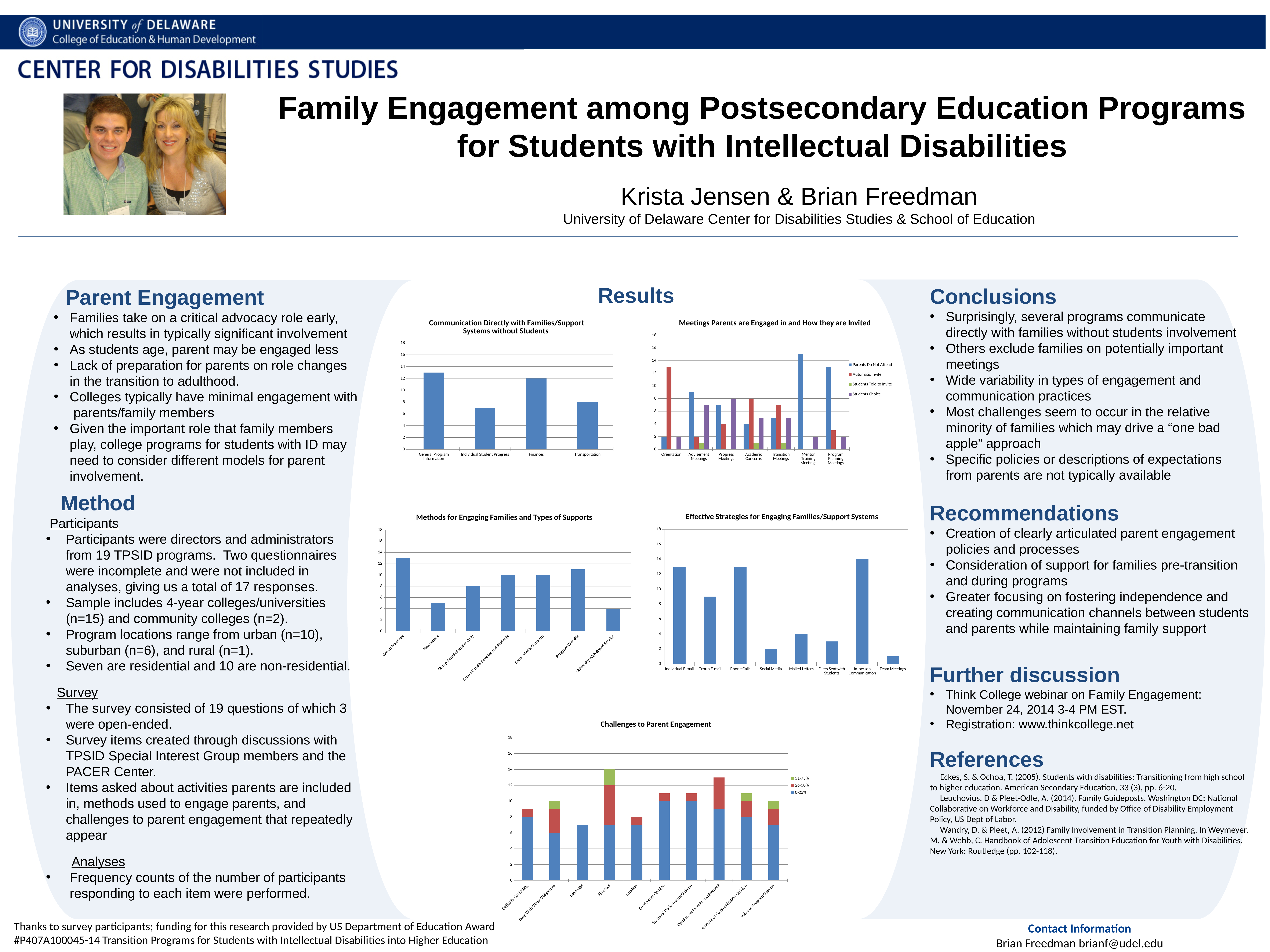
In the "Meetings Parents are Engaged in and How they are Invited" chart, which category has the highest "Parents Do Not Attend" value? Mentor Training Meetings How many series does the legend of the "Challenges to Parent Engagement" chart list? 3 How many categories does the "Communication Directly with Families/Support Systems without Students" chart show? 4 What kind of chart is the "Communication Directly with Families/Support Systems without Students" chart? bar chart In the "Communication Directly with Families/Support Systems without Students" chart, is the value for Individual Student Progress greater or less than 10? less In the "Effective Strategies for Engaging Families/Support Systems" chart, which category has the lowest value? Team Meetings How many categories does the "Effective Strategies for Engaging Families/Support Systems" chart show? 8 In the "Communication Directly with Families/Support Systems without Students" chart, which category has the highest value? General Program Information In the "Methods for Engaging Families and Types of Supports" chart, which is larger, Group Meetings or Newsletters? Group Meetings In the "Effective Strategies for Engaging Families/Support Systems" chart, is the value for In-person Communication greater or less than 12? greater In the "Methods for Engaging Families and Types of Supports" chart, which category has the lowest value? University Web-Based Service How many series does the legend of the "Meetings Parents are Engaged in and How they are Invited" chart list? 4